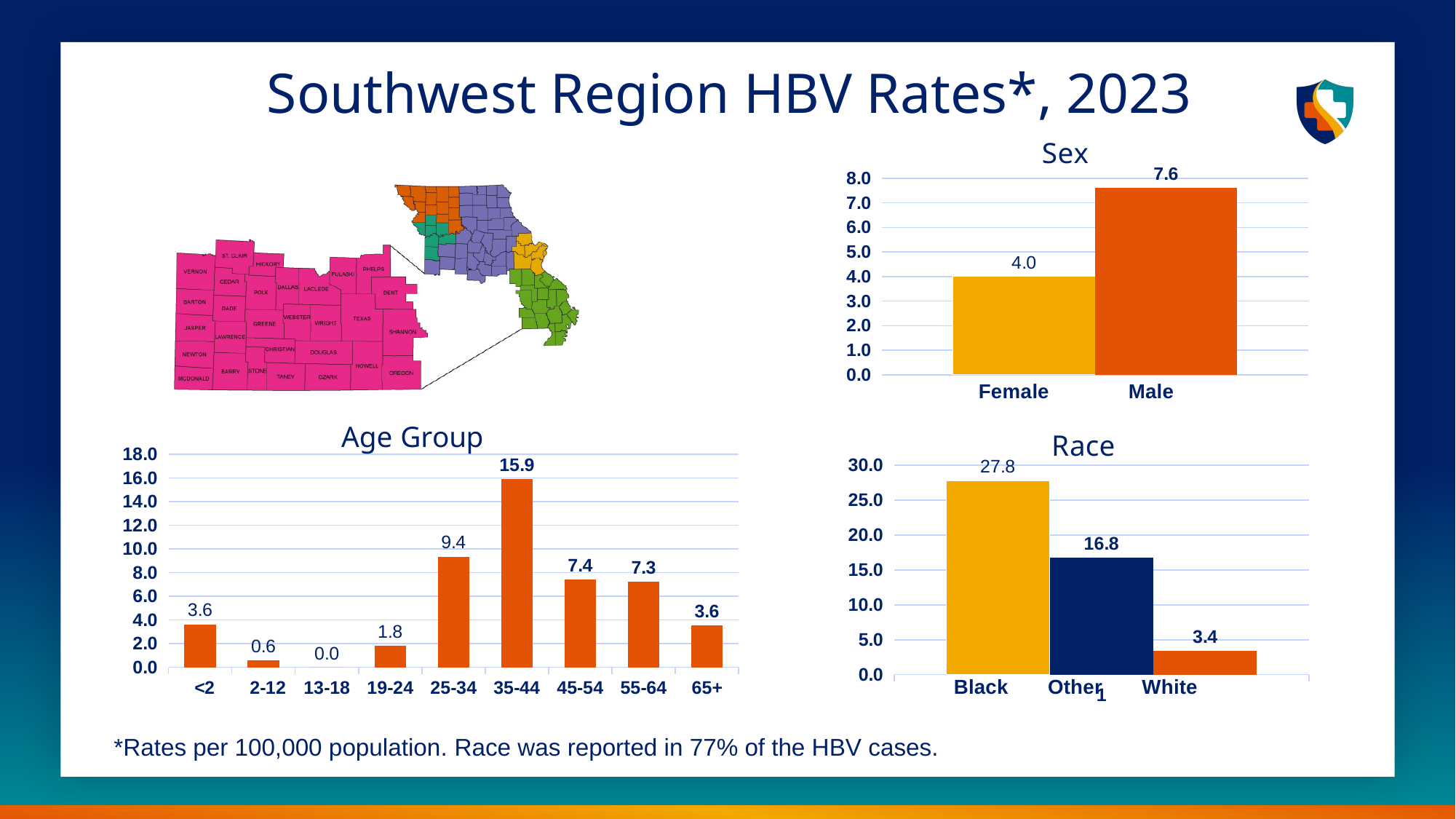
In the Race chart, what is the rate for Black? 27.8 In the Age Group chart, which age group has the lowest rate? 13-18 In the Race chart, which category has the lowest rate? White In the Age Group chart, which age group has the highest rate? 35-44 In the Age Group chart, how many age groups are shown? 9 In the Age Group chart, what is the rate for the 25-34 age group? 9.4 What kind of chart is the Race chart? bar chart In the Sex chart, what is the HBV rate for Male? 7.6 In the Sex chart, what is the difference between the Male and Female rates? 3.6 In the Race chart, is the rate for Other larger or smaller than the rate for White? larger In the Age Group chart, what is the difference between the rates for 35-44 and 45-54? 8.5 In the Sex chart, what is the HBV rate for Female? 4.0